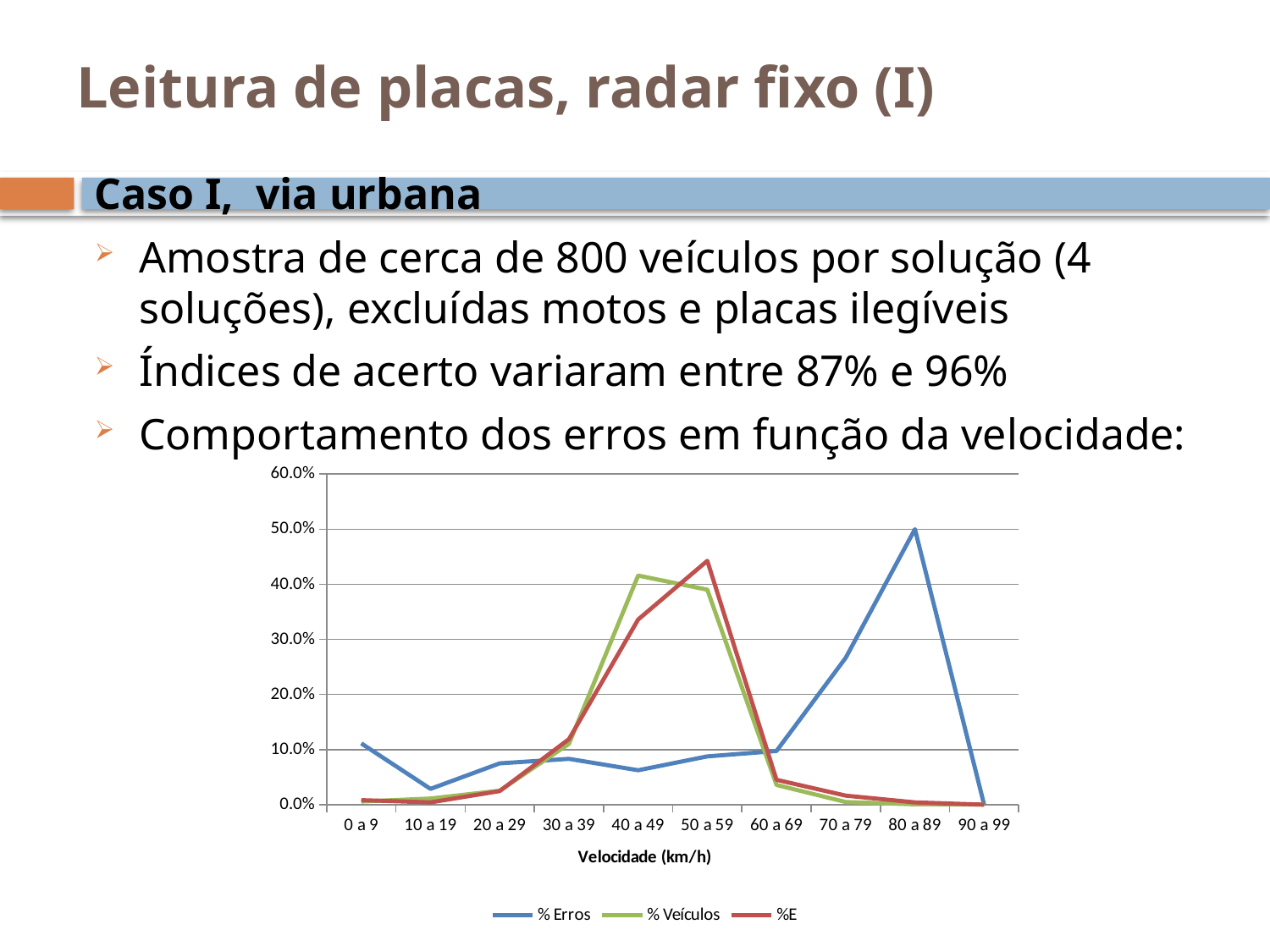
At 40 a 49, which series has the larger value, % Veículos or % Erros? % Veículos Does the % Erros series rise or fall from 60 a 69 to 80 a 89? Rises In which speed category does the %E series reach its highest value? 50 a 59 In which speed category does the % Veículos series reach its highest value? 40 a 49 What kind of chart is shown on the slide? Line chart Which series is drawn in blue in the chart? % Erros Is the value of % Erros for 10 a 19 greater or less than 10.0%? less Is the value of % Erros for 80 a 89 greater or less than 40.0%? greater In which speed category does the % Erros series reach its highest value? 80 a 89 How many series does the chart legend list? 3 How many speed categories are shown on the x axis of the chart? 10 What is the title of the x axis of the chart? Velocidade (km/h)